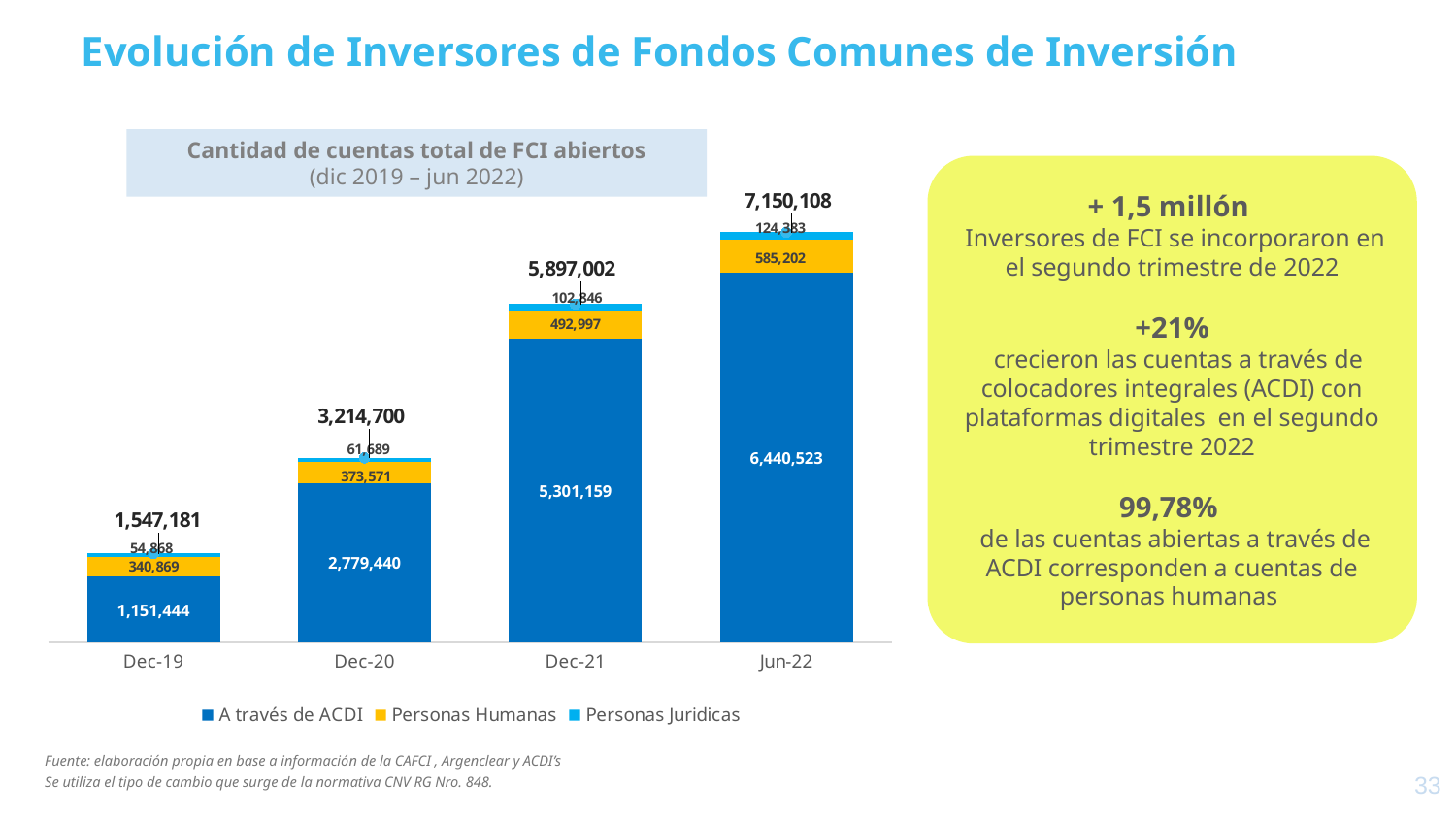
What is the value for 'Personas Juridicas' in Dec-20? 61,689 What is the value for 'A través de ACDI' in Dec-21? 5,301,159 Which period has the lowest value for 'A través de ACDI'? Dec-19 How many time periods are shown on the x axis of the chart? 4 What type of chart is shown on the slide? Stacked bar chart What is the value for 'Personas Humanas' in Jun-22? 585,202 What is the difference between the total for Jun-22 and the total for Dec-21? 1,253,106 Is the 'Personas Humanas' value larger in Dec-21 or in Dec-20? Dec-21 What is the total number of accounts shown for Dec-20? 3,214,700 How many series does the chart legend list? 3 Which period has the highest total number of accounts? Jun-22 What is the title of the chart? Cantidad de cuentas total de FCI abiertos (dic 2019 – jun 2022)